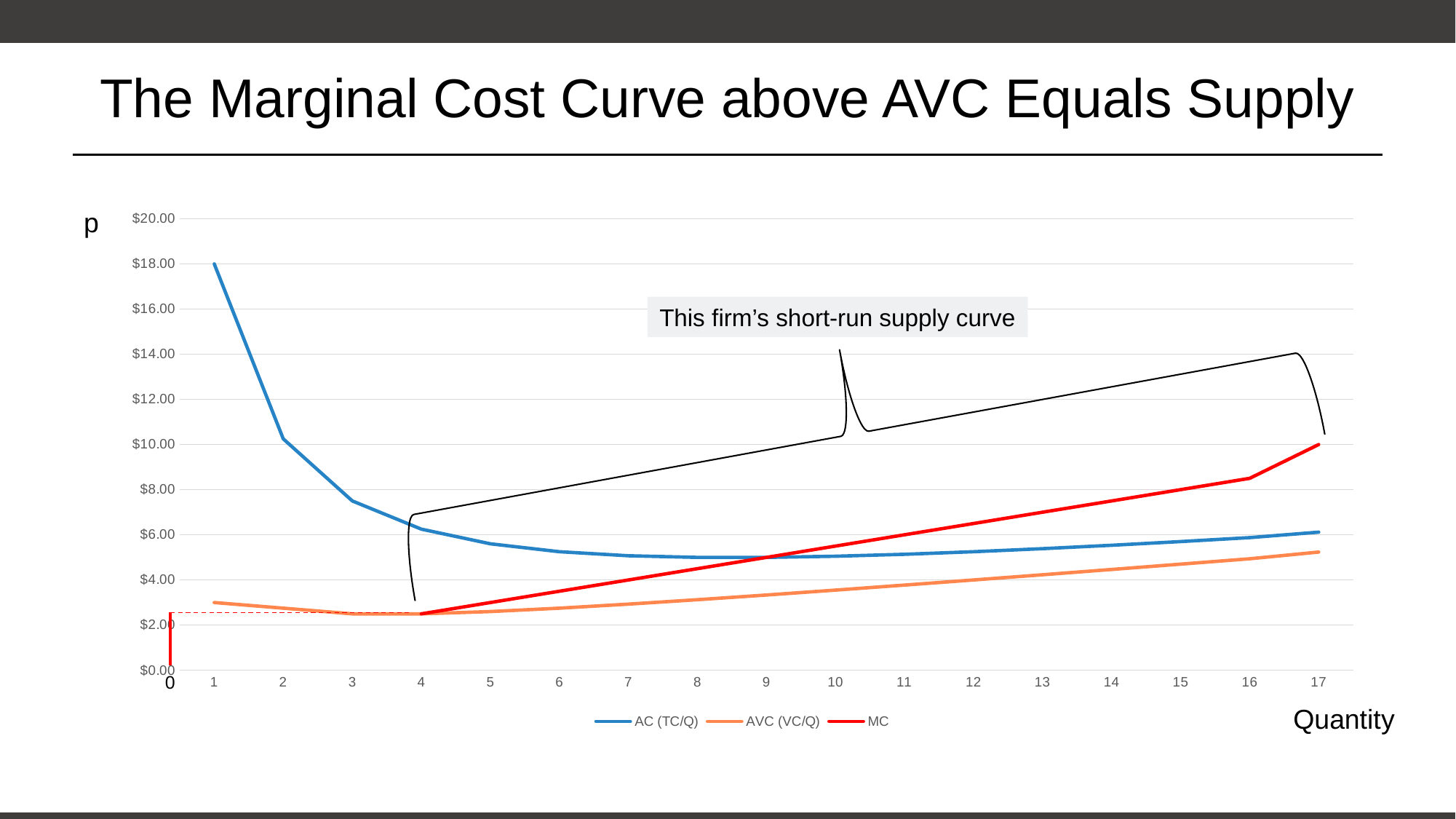
How many quantity values are labelled along the x axis? 17 How many series does the legend list? 3 Is the value of AC (TC/Q) at quantity 1 greater or less than $16.00? greater What is the value of AC (TC/Q) at quantity 1? $18.00 What does the text annotation on the chart say? This firm's short-run supply curve Is the value of AVC (VC/Q) at quantity 17 greater or less than $6.00? less Is the value of MC at quantity 17 greater or less than $8.00? greater At quantity 17, which is larger: AC (TC/Q) or MC? MC Which series reaches the highest value anywhere on the chart? AC (TC/Q) Does the MC curve rise or fall as quantity increases from 4 to 17? rise What kind of chart is shown on the slide? line chart Does the AC (TC/Q) curve rise or fall as quantity increases from 1 to 8? fall